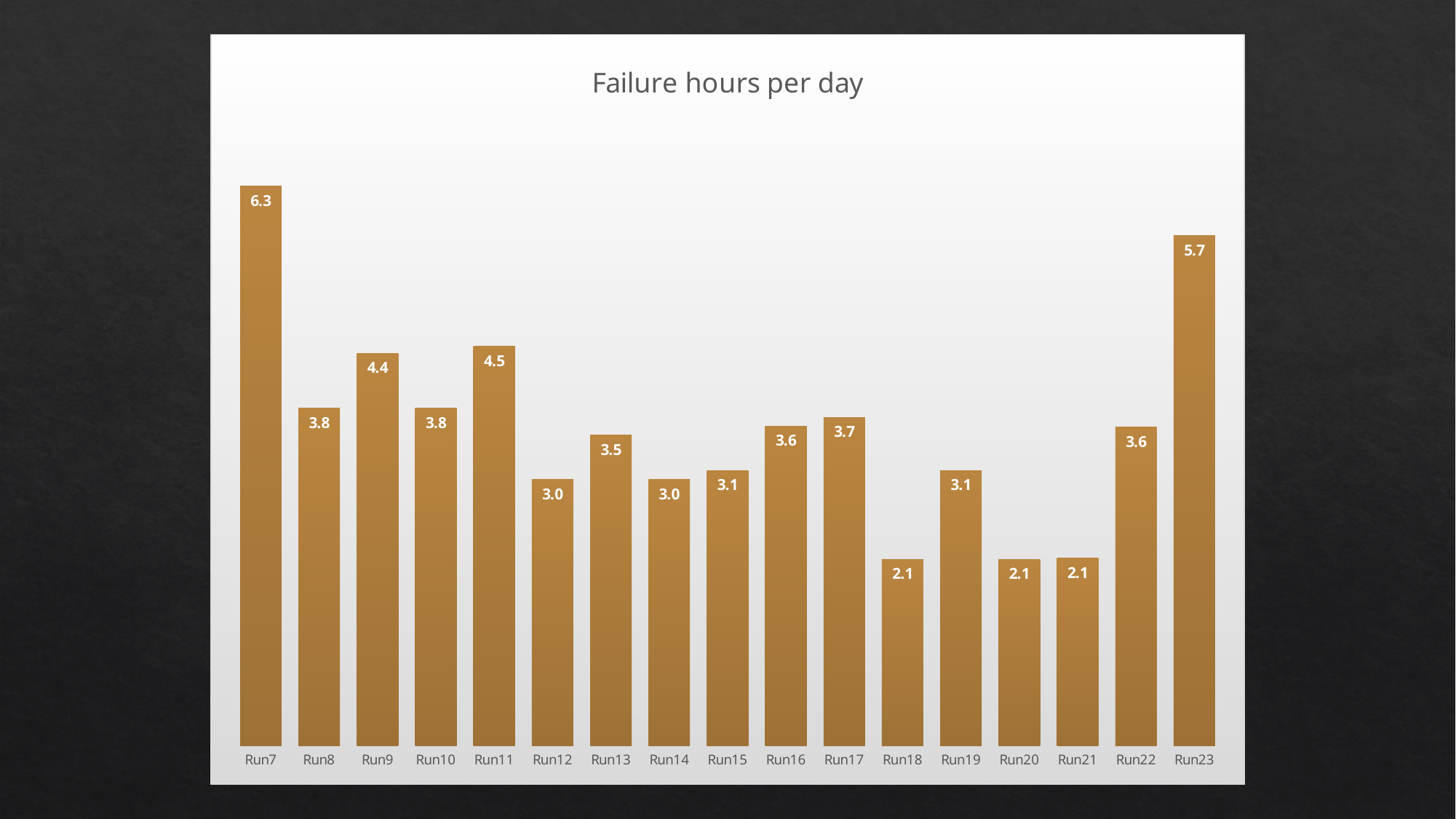
What is the difference between the values for Run9 and Run8? 0.6 What is the title of the chart? Failure hours per day What is the value shown for Run17? 3.7 Which is larger, the value for Run16 or the value for Run18? Run16 What is the value shown for Run11? 4.5 What is the difference between the values for Run7 and Run23? 0.6 What is the failure hours per day value for Run7? 6.3 What is the value shown for Run23? 5.7 What kind of chart is shown on the slide? Bar chart Which run has the highest failure hours per day? Run7 How many runs are shown on the x axis? 17 Which is larger, the value for Run13 or the value for Run19? Run13